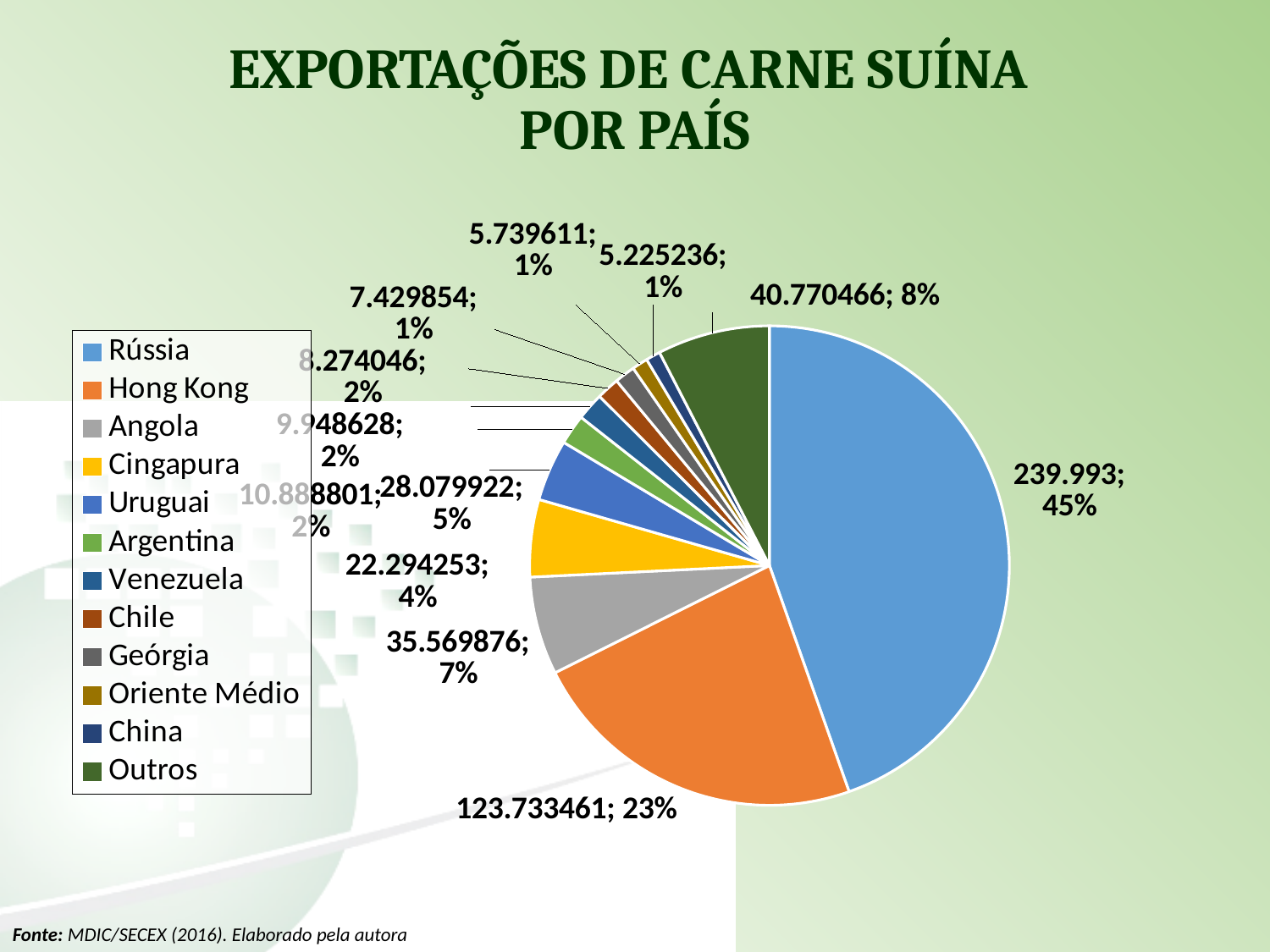
Which is larger, the value for Outros or the value for Angola? Outros What share of the pie does Hong Kong represent? 23% What is the title of the chart? EXPORTAÇÕES DE CARNE SUÍNA POR PAÍS What share of the pie does Outros represent? 8% How many entries does the legend list? 12 How many slices does the pie chart have? 12 Which country has the largest slice of the pie? Rússia What kind of chart is shown on the slide? pie chart What is the difference between the values for Rússia and Hong Kong? 116.259539 What value is shown for Hong Kong? 123.733461 What share of the pie does Rússia represent? 45% What value is shown for Rússia? 239.993